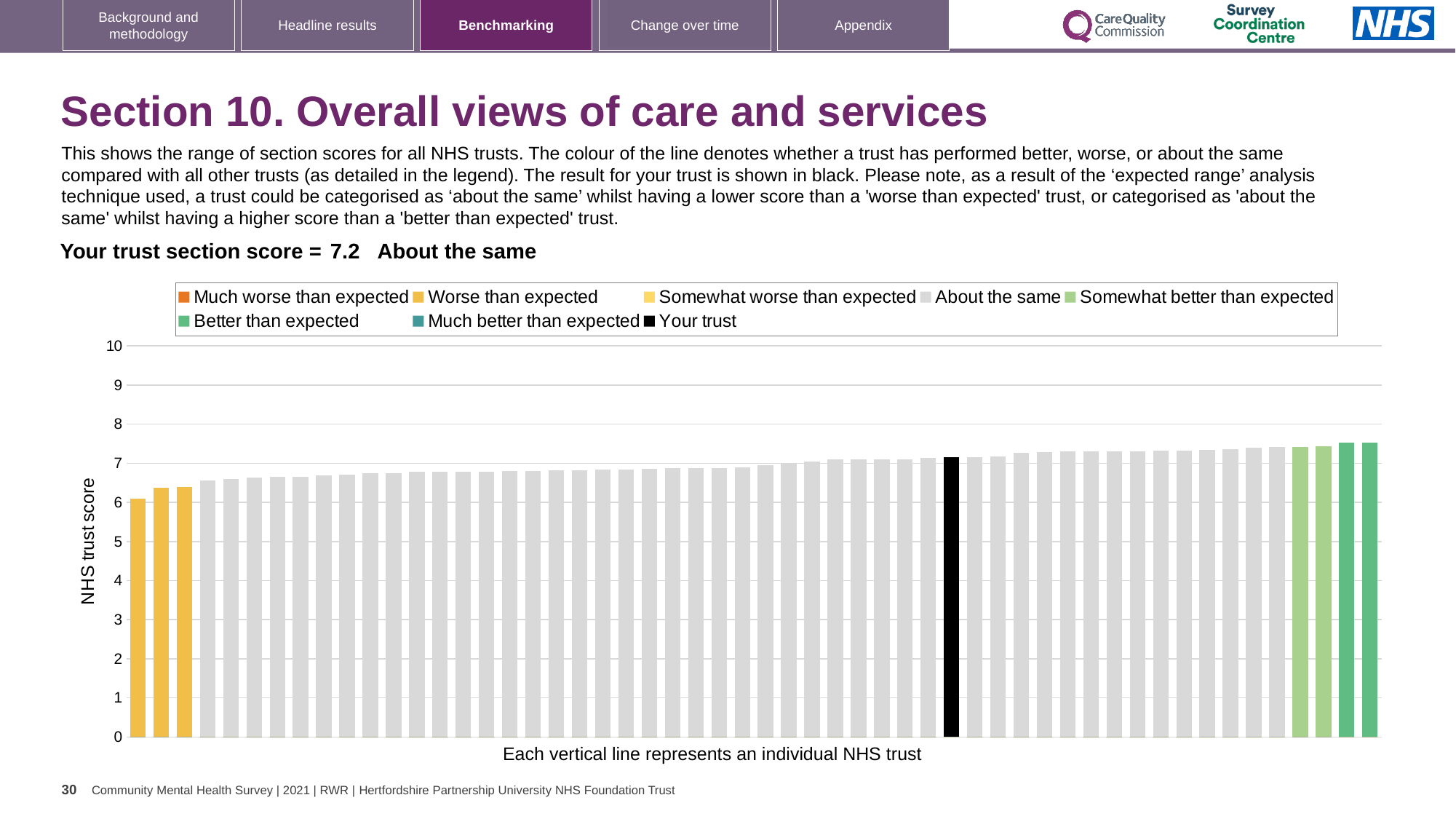
Is the value of the black 'Your trust' bar greater or less than 7? greater Do the bar values rise or fall from left to right along the x axis? Rise What is the label on the y axis of the chart? NHS trust score Is the value of the rightmost bar greater or less than 8? less How many entries does the chart legend list? 8 Which category is your trust placed in according to the slide? About the same What does each vertical line in the chart represent, according to the x-axis label? An individual NHS trust What is the section score for your trust (the black bar)? 7.2 How many bars are coloured in the 'Worse than expected' colour (yellow)? 3 Is the black 'Your trust' bar higher or lower than the leftmost bar? Higher What kind of chart is shown on the slide? Bar chart